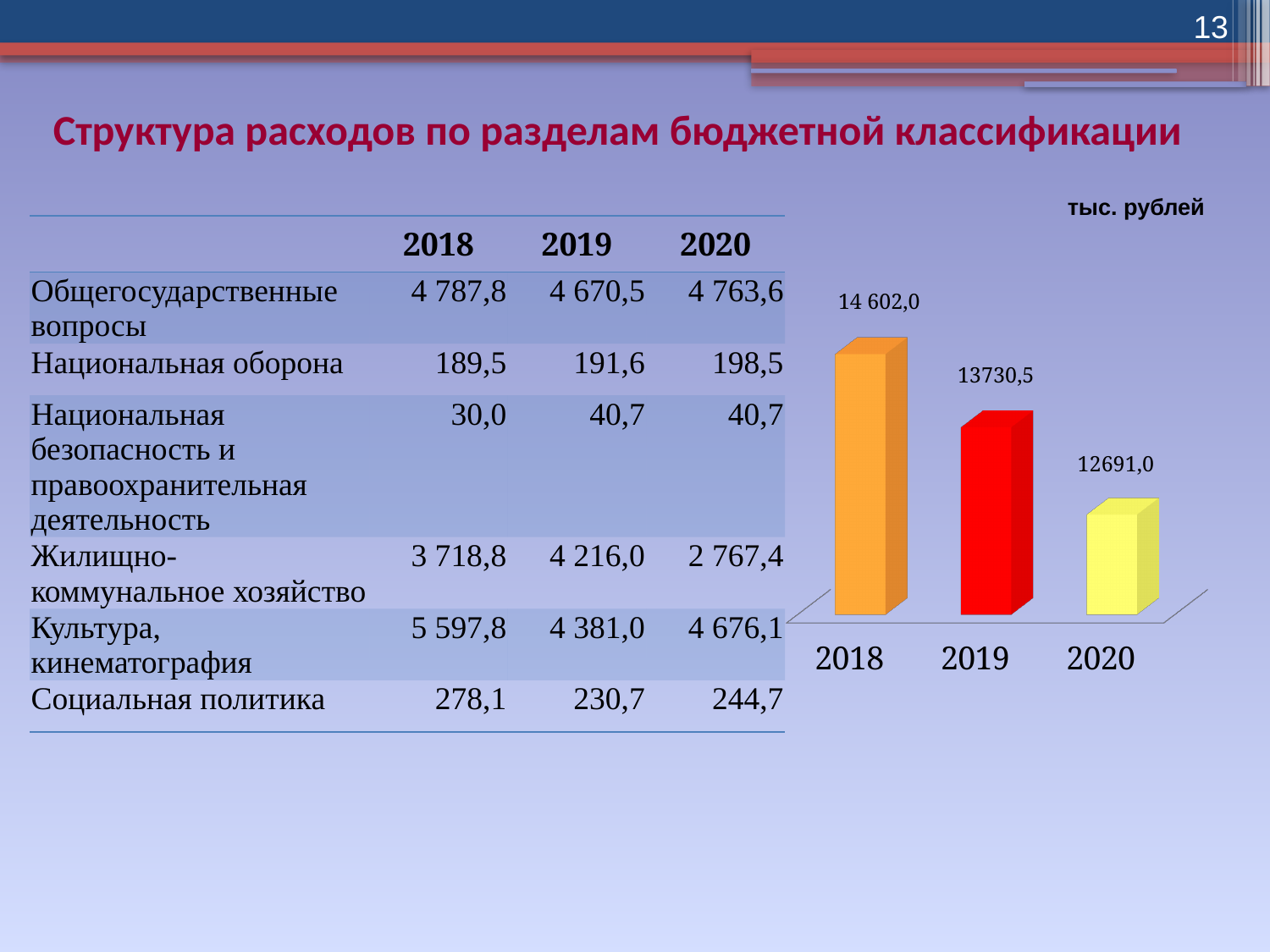
What is the value shown for 2019 in the bar chart? 13730,5 What is the value shown for 2020 in the bar chart? 12691,0 How many bars are plotted in the chart? 3 In the bar chart, what is the difference between the 2018 and 2019 values? 871,5 In the bar chart, what is the difference between the 2019 and 2020 values? 1039,5 What is the value shown for 2018 in the bar chart? 14 602,0 Which year has the lowest bar in the chart? 2020 Do the values in the bar chart rise or fall from 2018 to 2020? Fall What type of chart is shown on the right of the slide? Bar chart In the bar chart, what is the difference between the 2018 and 2020 values? 1911,0 Which year has the highest bar in the chart? 2018 In the bar chart, which is larger: the value for 2019 or the value for 2020? 2019